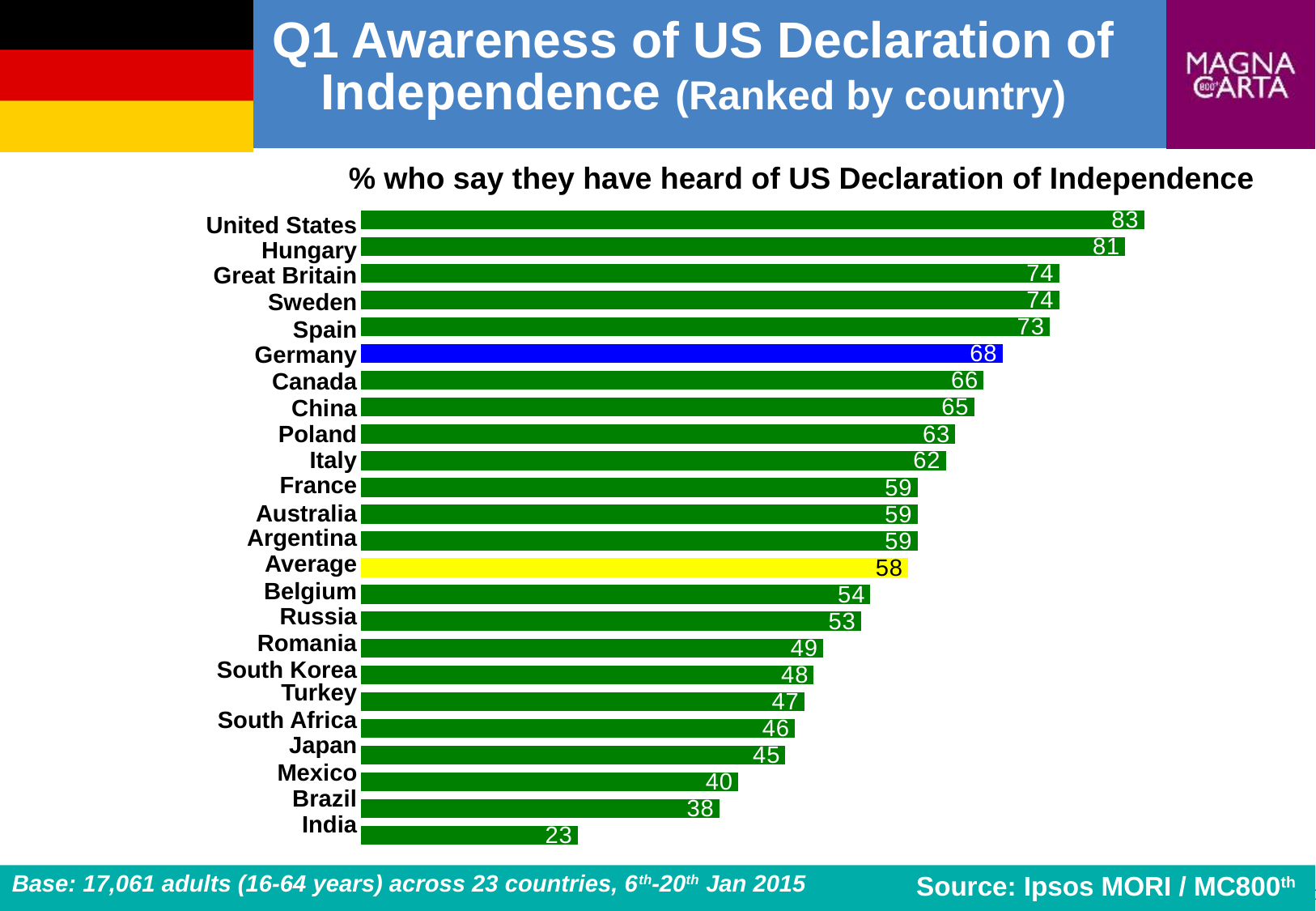
Which country has the lowest value? India Which has a larger value, Canada or Belgium? Canada Which has a larger value, Mexico or Hungary? Hungary Which bar is coloured blue? Germany What is the difference between the values for the United States and India? 60 Which country has the highest value? United States What kind of chart is shown on the slide? Bar chart What is the difference between the values for Germany and the Average? 10 What is the value for Germany? 68 What is the value for Japan? 45 What is the value for the Average bar? 58 How many bars are shown in the chart? 24